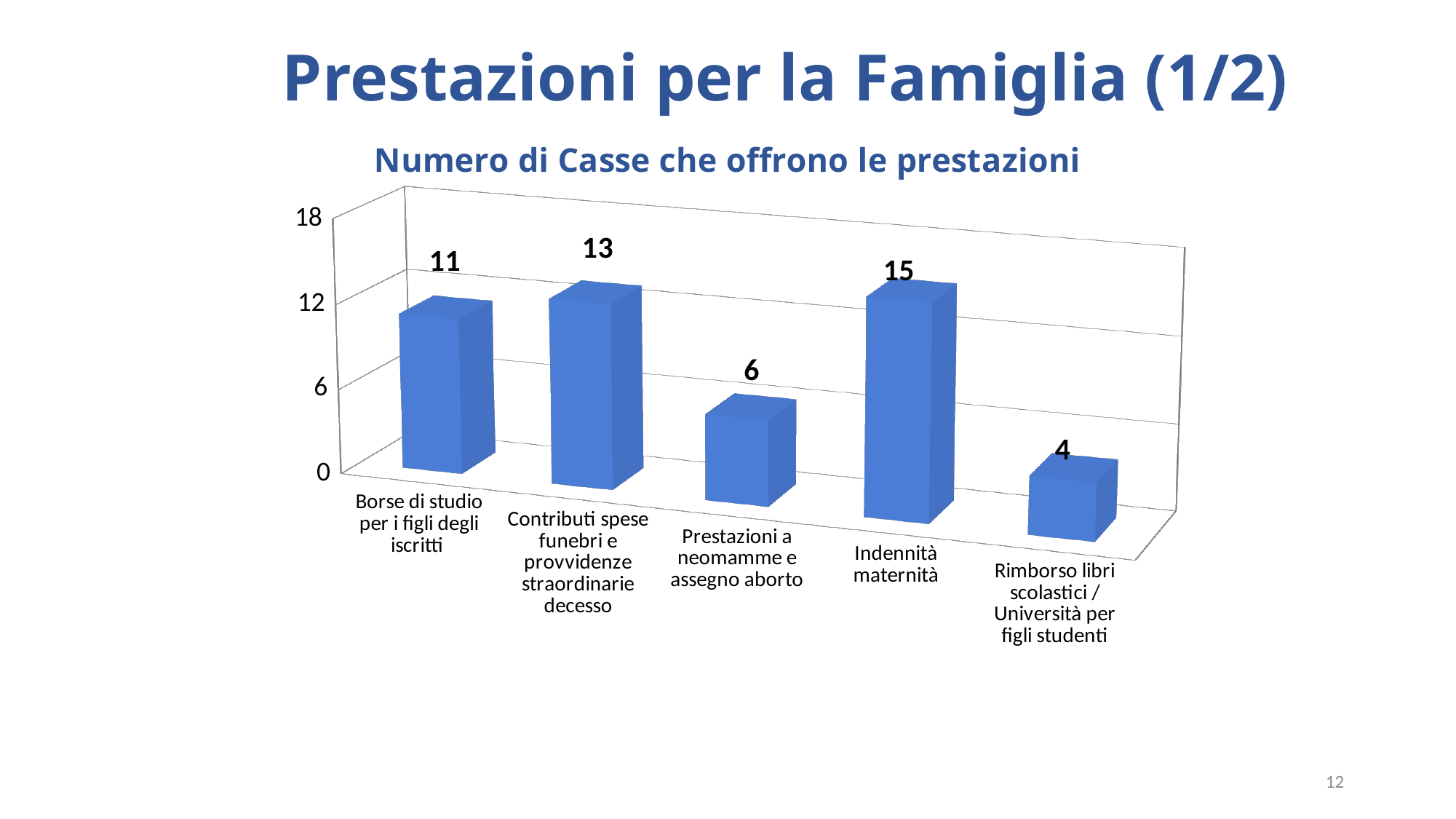
What is the value for Borse di studio per i figli degli iscritti? 11 What is the value for Prestazioni a neomamme e assegno aborto? 6 Which category has the highest value? Indennità maternità What kind of chart is shown on the slide? bar chart What is the title of the chart? Numero di Casse che offrono le prestazioni What is the value for Rimborso libri scolastici / Università per figli studenti? 4 Which is larger: the value for Borse di studio per i figli degli iscritti or the value for Prestazioni a neomamme e assegno aborto? Borse di studio per i figli degli iscritti How many categories are shown in the chart? 5 What is the value for Indennità maternità? 15 Is the value for Contributi spese funebri e provvidenze straordinarie decesso greater or less than 12? greater What is the difference between the values for Indennità maternità and Contributi spese funebri e provvidenze straordinarie decesso? 2 Which category has the lowest value? Rimborso libri scolastici / Università per figli studenti